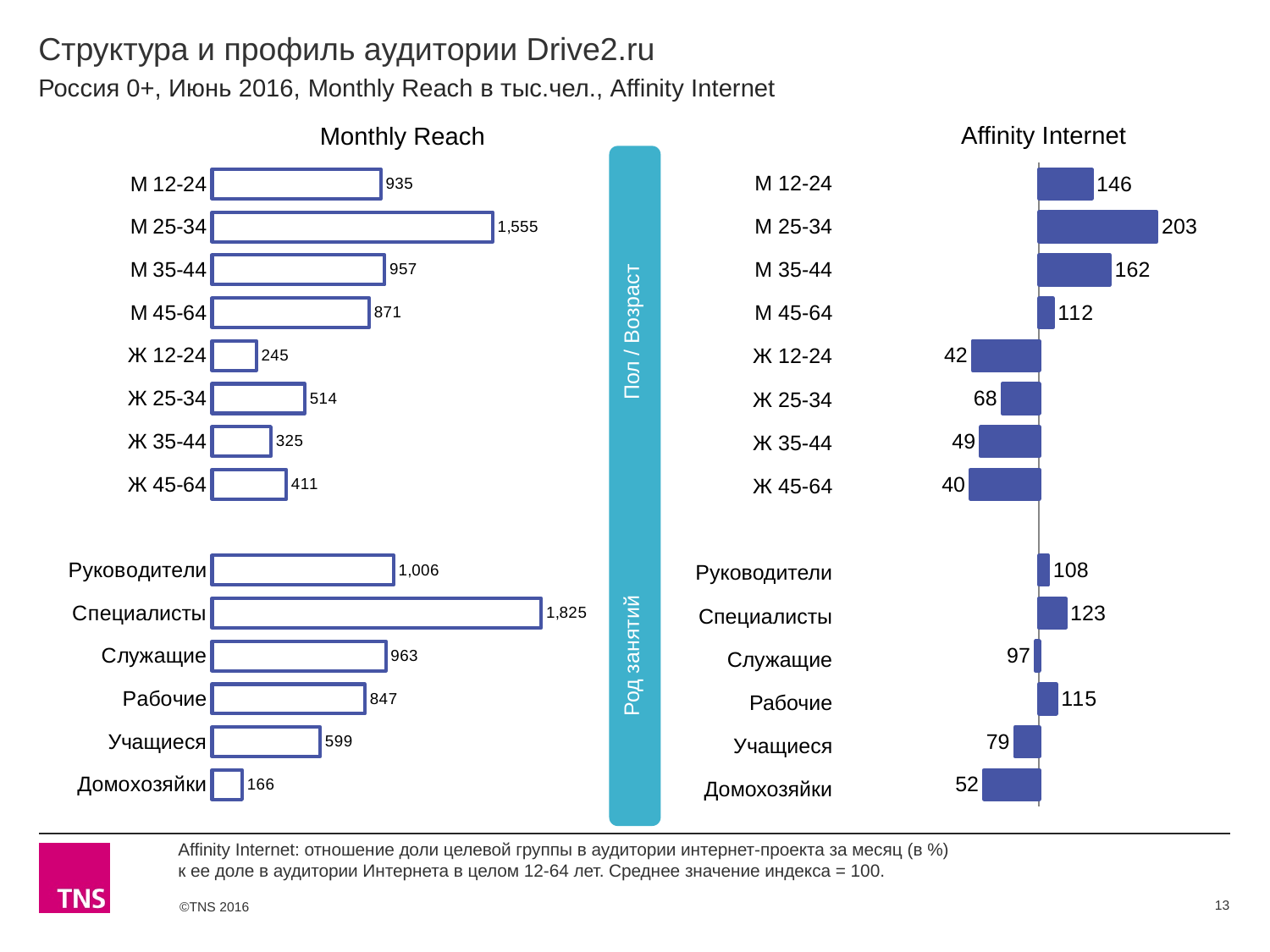
In the Monthly Reach chart, what is the difference between the values for Руководители and Рабочие? 159 In the Affinity Internet chart, which category has the lowest value? Ж 45-64 What kind of chart is the Affinity Internet chart? Bar chart In the Monthly Reach chart, which category has the highest value? Специалисты In the Monthly Reach chart, which category has the lowest value? Домохозяйки In the Affinity Internet chart, what is the value for Ж 45-64? 40 In the Affinity Internet chart, what is the difference between the values for М 35-44 and М 45-64? 50 In the Affinity Internet chart, which is larger: the value for Учащиеся or Служащие? Служащие In the Monthly Reach chart, which is larger: the value for Ж 25-34 or Ж 45-64? Ж 25-34 In the Affinity Internet chart, which category has the highest value? М 25-34 How many categories are plotted in the Monthly Reach chart? 14 In the Monthly Reach chart, what is the value for М 25-34? 1,555